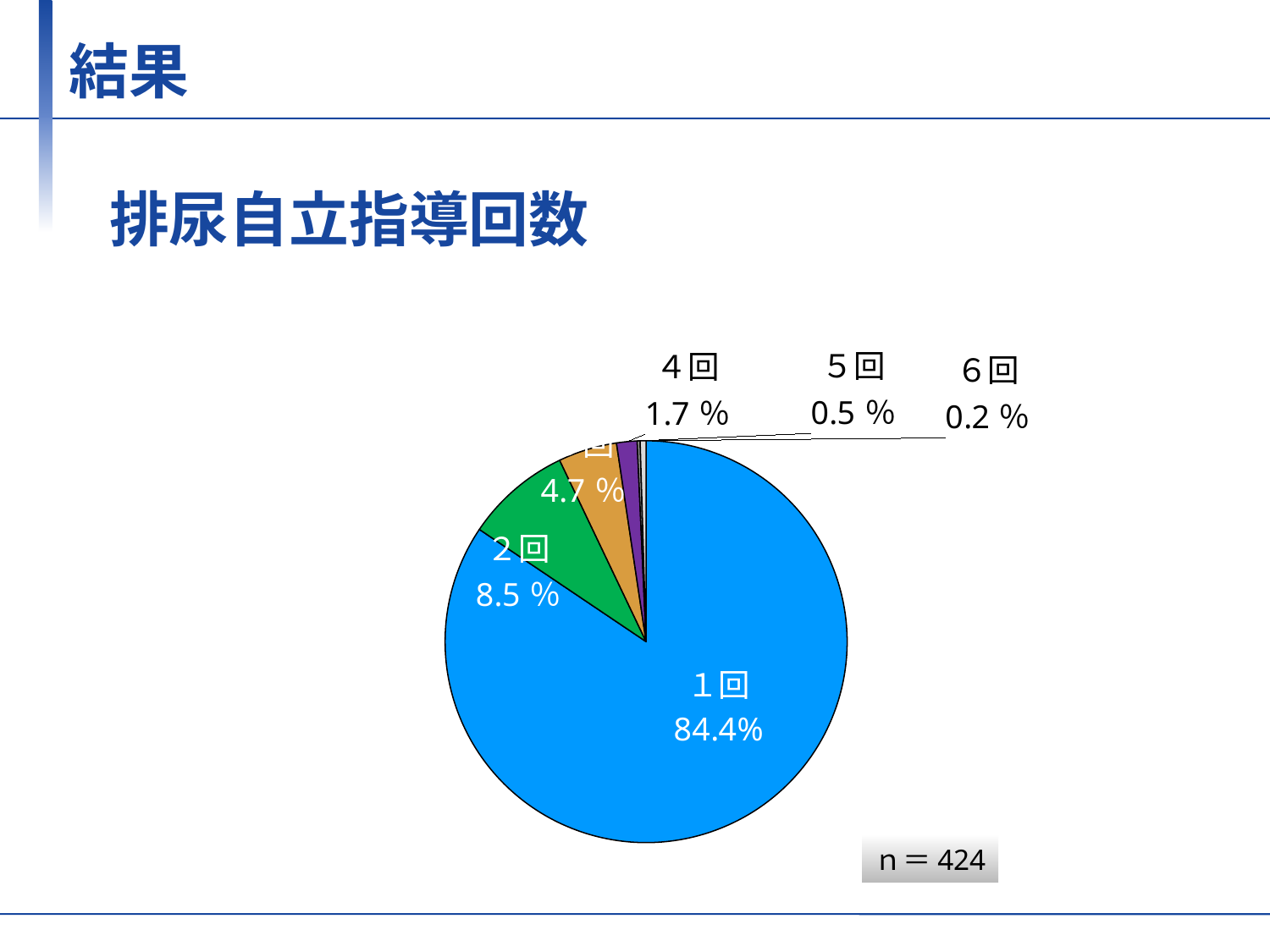
What sample size (n) is shown next to the pie chart? n = 424 What percentage is shown for the 4回 slice? 1.7 % Which category has the smallest share of the pie chart? 6回 What percentage is shown for the 2回 slice? 8.5 % By how many percentage points does the 1回 share exceed the 2回 share? 75.9 percentage points What kind of chart is shown on the slide? Pie chart Which category has the largest share of the pie chart? 1回 How many slices does the pie chart have? 6 Which slice is larger, 2回 or 4回? 2回 What percentage is shown for the 5回 slice? 0.5 % What percentage is shown for the 6回 slice? 0.2 % What percentage of the pie chart is the 1回 slice? 84.4%